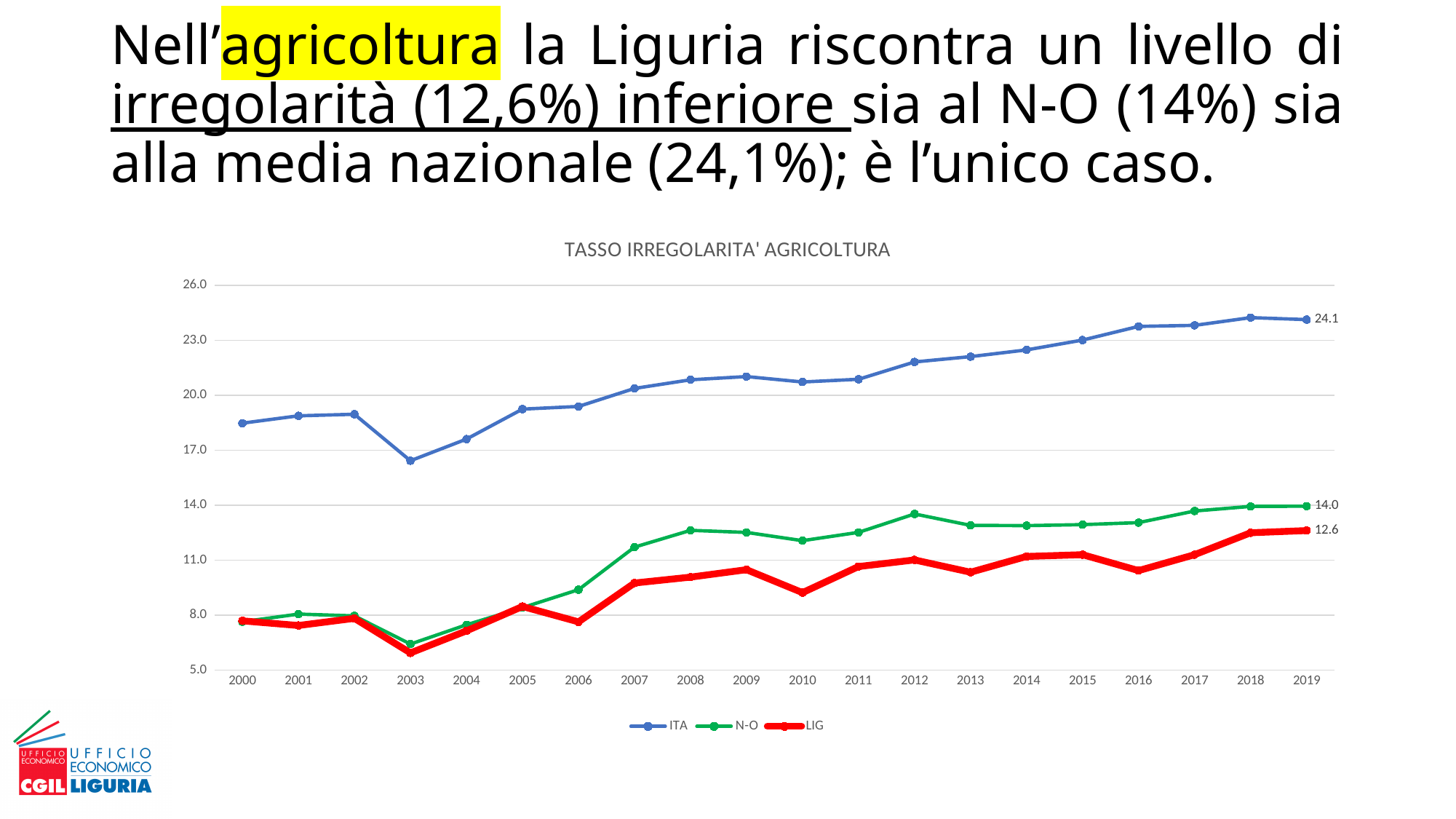
What is the difference between the N-O and LIG values in 2019? 1.4 What kind of chart is shown on the slide? line chart What is the value for N-O in 2019? 14.0 Which series has the highest value in 2019? ITA How many series does the legend list? 3 Which series has the lowest value in 2019? LIG What is the value for LIG in 2019? 12.6 What is the title of the chart? TASSO IRREGOLARITA' AGRICOLTURA How many years are shown on the x axis? 20 Is the value for ITA in 2003 greater or less than 17.0? less What is the difference between the ITA and LIG values in 2019? 11.5 What is the value for ITA in 2019? 24.1